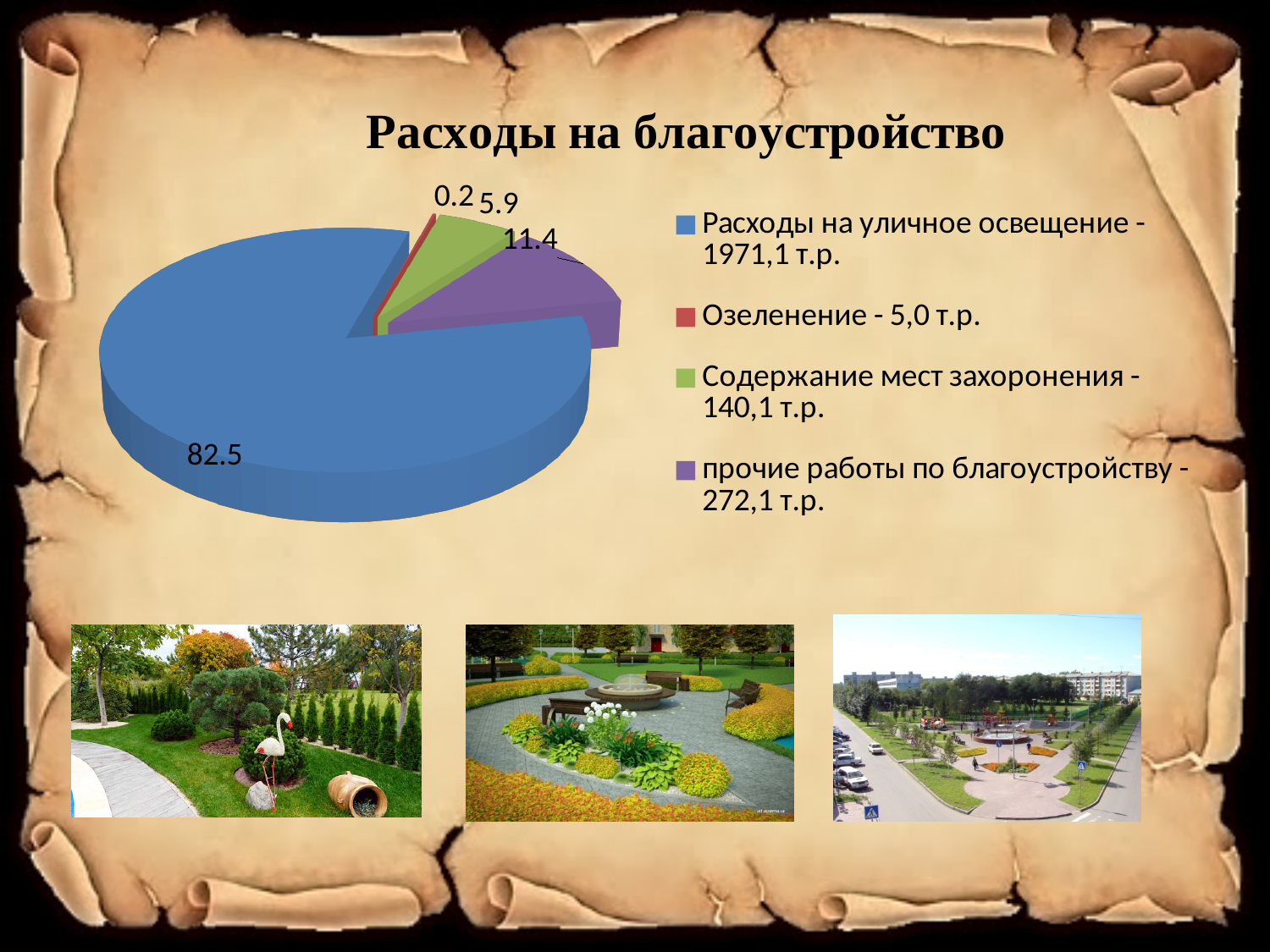
What data label is shown on the slice for Озеленение? 0.2 Which category has the smallest slice of the pie? Озеленение How many entries does the legend list? 4 What data label is shown on the slice for прочие работы по благоустройству? 11.4 What data label is shown on the slice for Содержание мест захоронения? 5.9 What is the title of the chart? Расходы на благоустройство Which category has the largest slice of the pie? Расходы на уличное освещение What is the difference between the data labels for прочие работы по благоустройству and Содержание мест захоронения? 5.5 Which colour represents Содержание мест захоронения in the chart? green How many slices does the pie chart have? 4 What kind of chart is shown on the slide? pie chart What data label is shown on the slice for Расходы на уличное освещение? 82.5